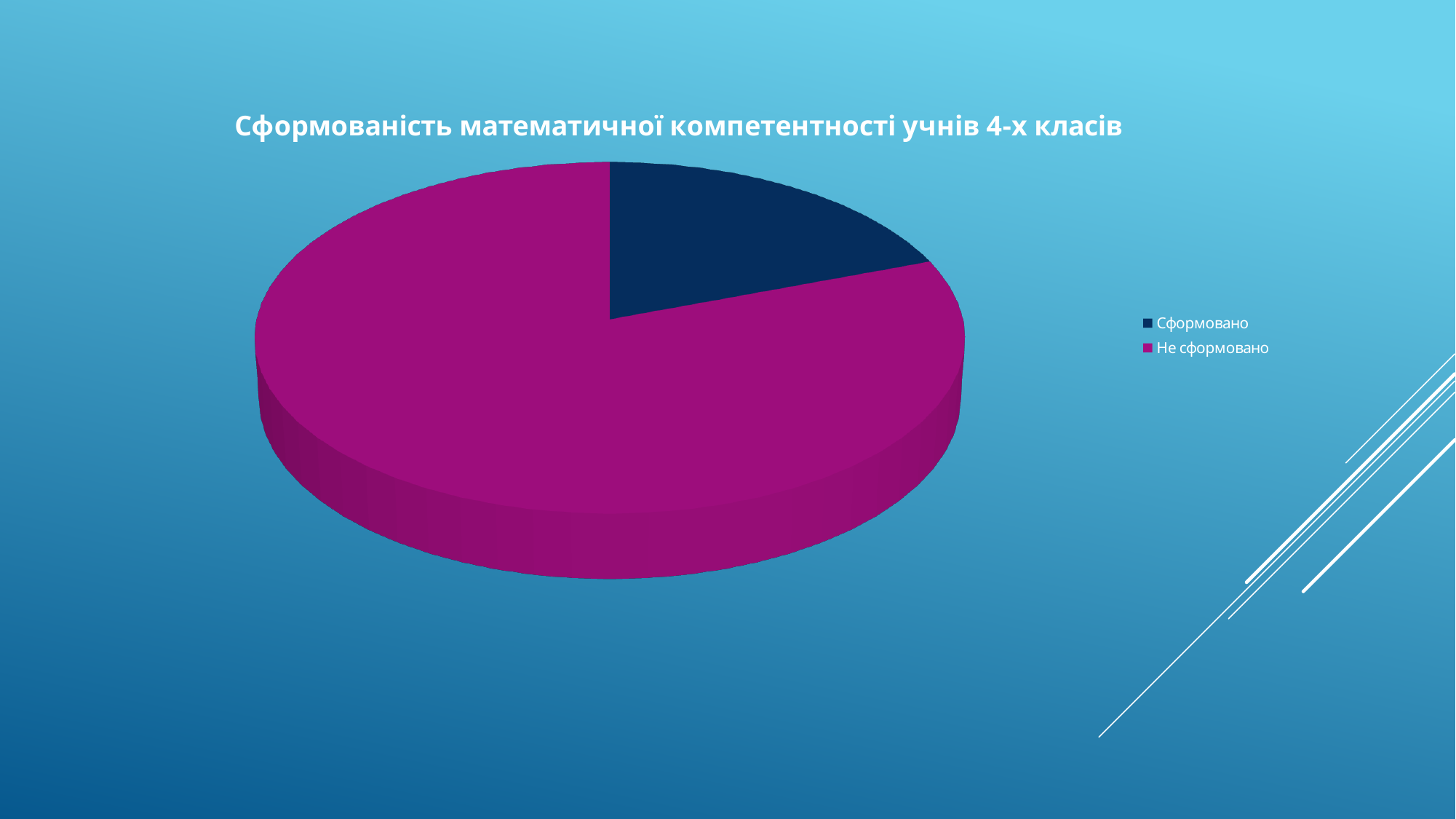
What is the title of the chart? Сформованість математичної компетентності учнів 4-х класів What colour is the slice for Сформовано? Dark blue Which slice is larger, Сформовано or Не сформовано? Не сформовано How many entries does the legend list? 2 Which category has the largest slice of the pie? Не сформовано How many slices does the pie chart have? 2 Which category has the smallest slice of the pie? Сформовано What kind of chart is shown on the slide? Pie chart